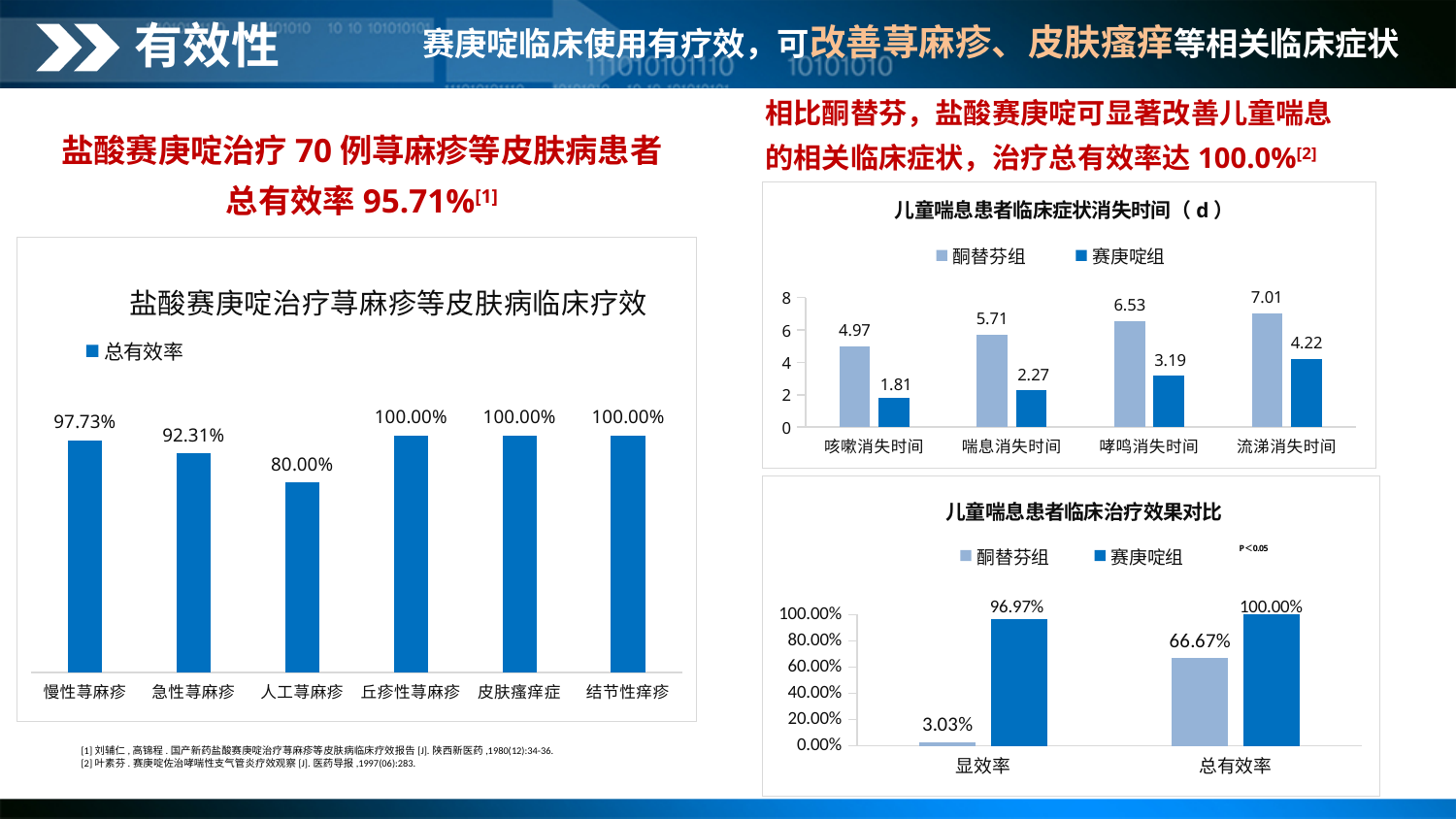
In the chart titled 盐酸赛庚啶治疗荨麻疹等皮肤病临床疗效, what is the difference between the 总有效率 for 慢性荨麻疹 and 人工荨麻疹? 17.73% In the chart titled 儿童喘息患者临床症状消失时间（d）, do the values for 赛庚啶组 rise or fall from left to right along the x axis? rise In the chart titled 盐酸赛庚啶治疗荨麻疹等皮肤病临床疗效, which category has the lowest 总有效率? 人工荨麻疹 In the chart titled 儿童喘息患者临床治疗效果对比, which group has the larger 总有效率, 酮替芬组 or 赛庚啶组? 赛庚啶组 In the chart titled 儿童喘息患者临床症状消失时间（d）, what is the difference between 酮替芬组 and 赛庚啶组 at 咳嗽消失时间? 3.16 In the chart titled 盐酸赛庚啶治疗荨麻疹等皮肤病临床疗效, how many categories are shown on the x axis? 6 In the chart titled 儿童喘息患者临床症状消失时间（d）, how many series does the legend list? 2 What kind of chart is the one titled 儿童喘息患者临床治疗效果对比? bar chart In the chart titled 儿童喘息患者临床症状消失时间（d）, what is the value for 赛庚啶组 at 哮鸣消失时间? 3.19 In the chart titled 儿童喘息患者临床治疗效果对比, what is the 显效率 for 酮替芬组? 3.03% In the chart titled 盐酸赛庚啶治疗荨麻疹等皮肤病临床疗效, what is the 总有效率 for 急性荨麻疹? 92.31% In the chart titled 儿童喘息患者临床症状消失时间（d）, which category has the highest value for 酮替芬组? 流涕消失时间